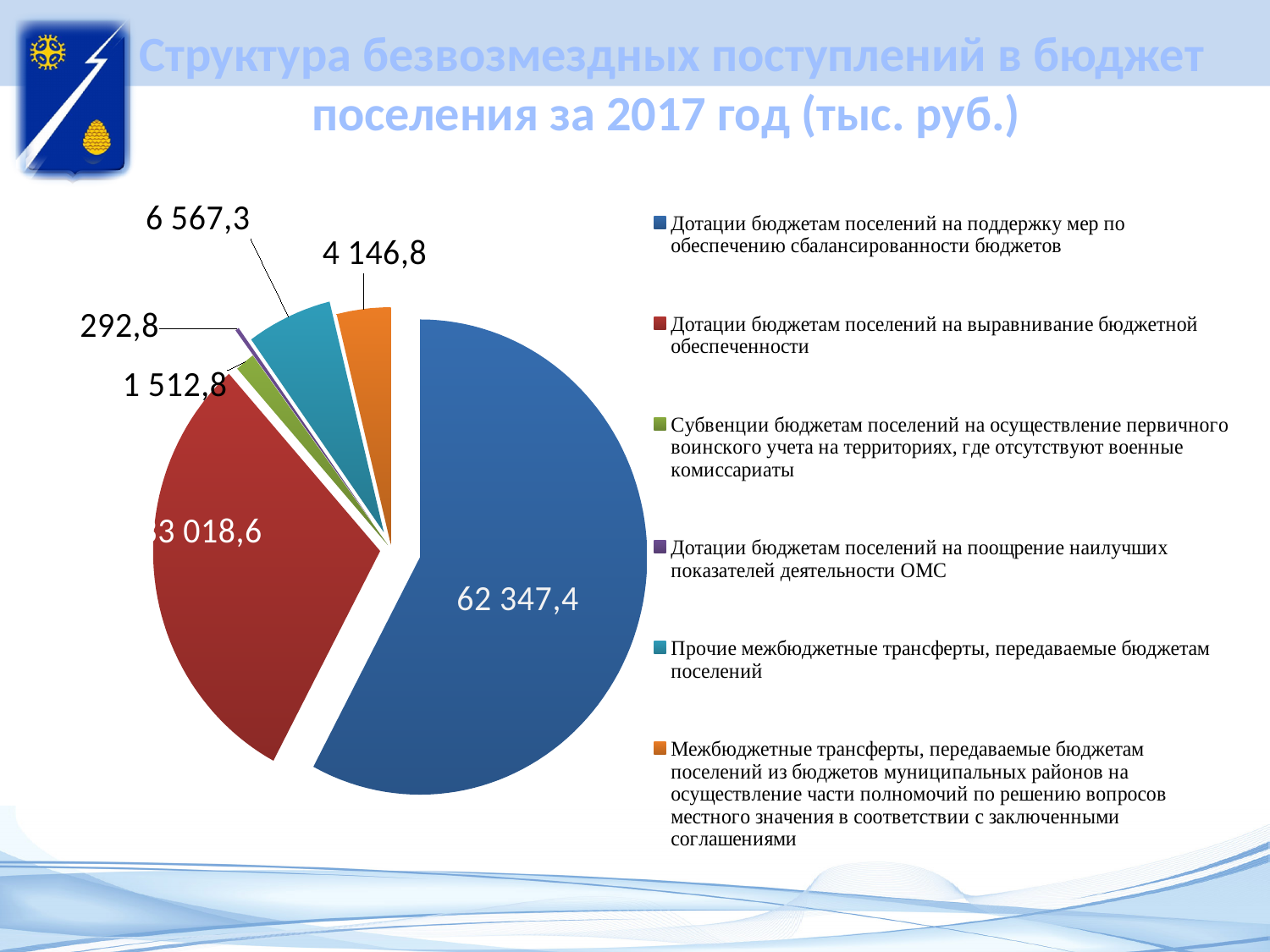
What is the value for "Дотации бюджетам поселений на поддержку мер по обеспечению сбалансированности бюджетов"? 62 347,4 What colour is the largest slice of the pie chart? blue What is the value for "Прочие межбюджетные трансферты, передаваемые бюджетам поселений"? 6 567,3 Which category has the smallest slice of the pie? Дотации бюджетам поселений на поощрение наилучших показателей деятельности ОМС What is the difference between the value for "Прочие межбюджетные трансферты" (6 567,3) and the value for "Межбюджетные трансферты из бюджетов муниципальных районов" (4 146,8)? 2 420,5 What is the value for "Дотации бюджетам поселений на поощрение наилучших показателей деятельности ОМС"? 292,8 Which is larger: the value for "Прочие межбюджетные трансферты, передаваемые бюджетам поселений" or the value for "Межбюджетные трансферты, передаваемые бюджетам поселений из бюджетов муниципальных районов"? Прочие межбюджетные трансферты, передаваемые бюджетам поселений What is the value for "Межбюджетные трансферты, передаваемые бюджетам поселений из бюджетов муниципальных районов на осуществление части полномочий"? 4 146,8 What kind of chart is shown on the slide? pie chart How many categories does the legend of the pie chart list? 6 Which category has the largest slice of the pie? Дотации бюджетам поселений на поддержку мер по обеспечению сбалансированности бюджетов What is the value for "Субвенции бюджетам поселений на осуществление первичного воинского учета"? 1 512,8